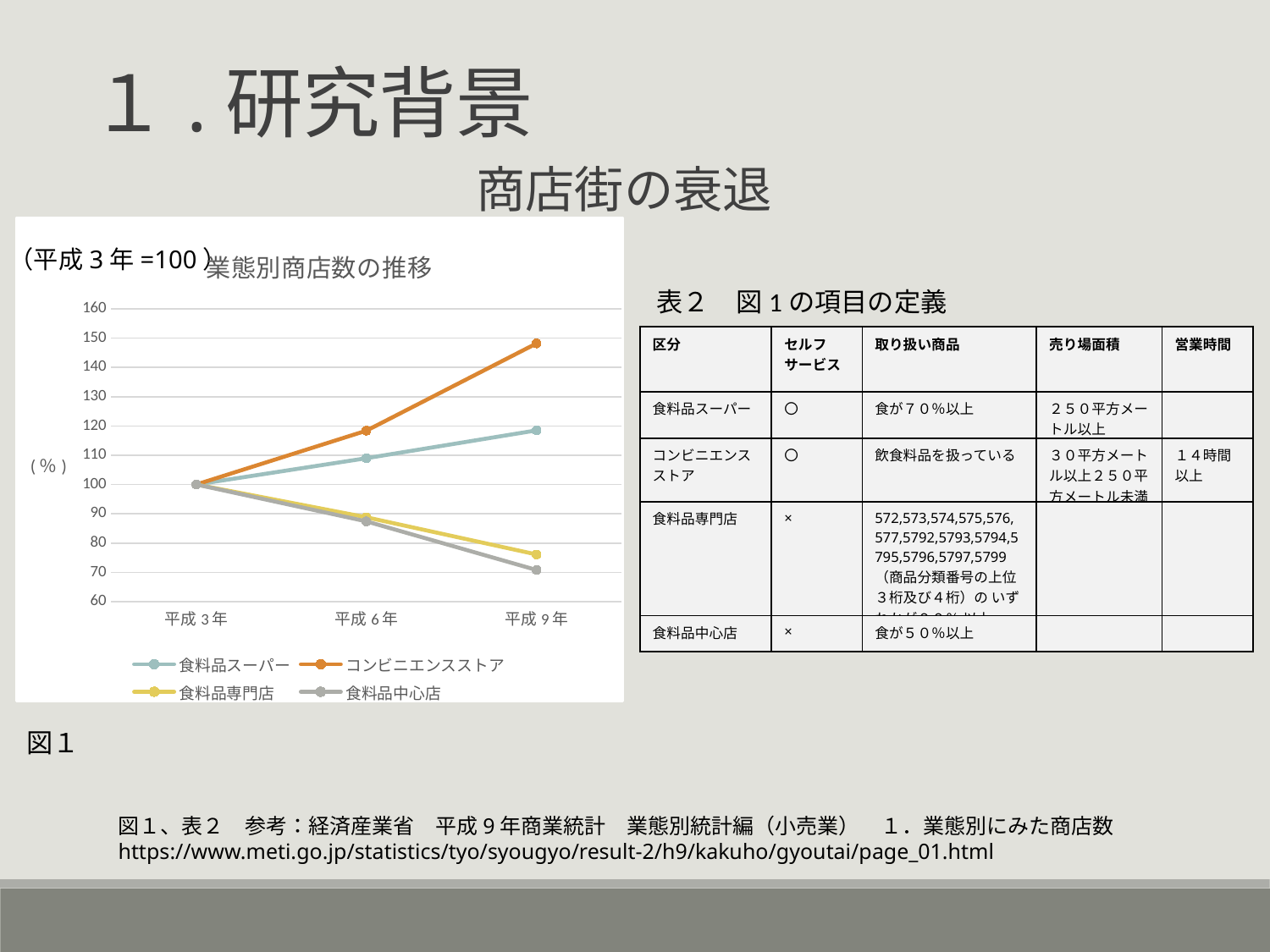
In 平成6年, which is larger: the value for コンビニエンスストア or for 食料品スーパー? コンビニエンスストア Does the value for 食料品専門店 rise or fall from 平成3年 to 平成9年? fall How many series does the legend of the chart list? 4 Which series has the lowest value in 平成9年? 食料品中心店 Is the value for コンビニエンスストア in 平成9年 greater or less than 140? greater What kind of chart is shown on the slide? line chart Is the value for 食料品中心店 in 平成9年 greater or less than 80? less Does the value for コンビニエンスストア rise or fall from 平成3年 to 平成9年? rise Which series has the highest value in 平成9年? コンビニエンスストア How many points are there along the x axis of the chart? 3 What is the value for コンビニエンスストア in 平成3年? 100 Is the value for 食料品スーパー in 平成9年 greater or less than 110? greater